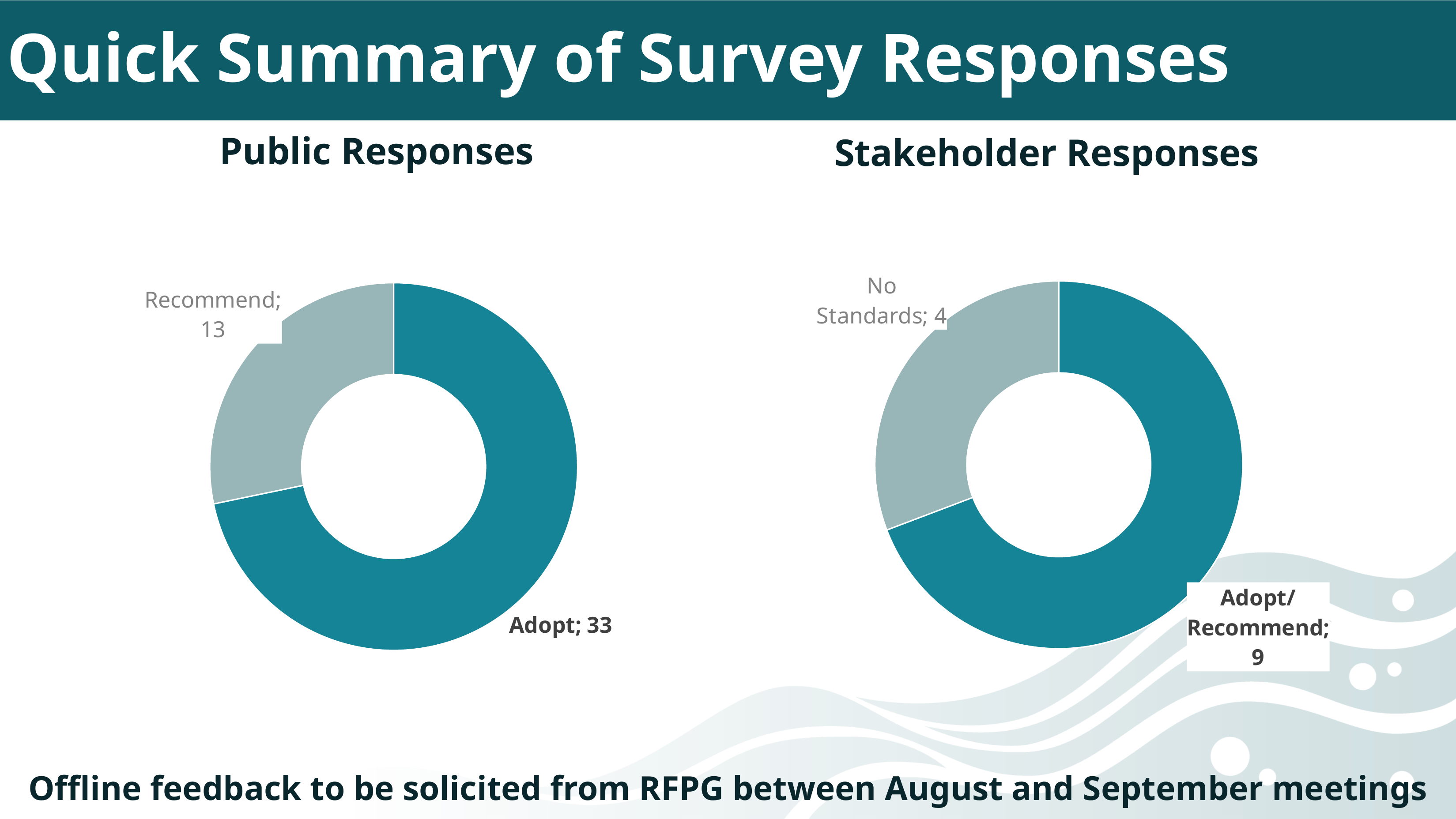
Which is larger: Adopt in the Public Responses chart or Adopt/Recommend in the Stakeholder Responses chart? Adopt in the Public Responses chart In the Stakeholder Responses chart, what is the value for No Standards? 4 What kind of chart is the Stakeholder Responses chart? Doughnut (pie) chart In the Public Responses chart, what is the value for Recommend? 13 In the Public Responses chart, which category has the largest value? Adopt In the Stakeholder Responses chart, what is the value for Adopt/Recommend? 9 In the Public Responses chart, what is the value for Adopt? 33 In the Public Responses chart, what is the difference between Adopt and Recommend? 20 How many categories does the Public Responses chart show? 2 In the Stakeholder Responses chart, which category has the smallest value? No Standards What is the total of all values in the Public Responses chart? 46 In the Stakeholder Responses chart, what is the difference between Adopt/Recommend and No Standards? 5